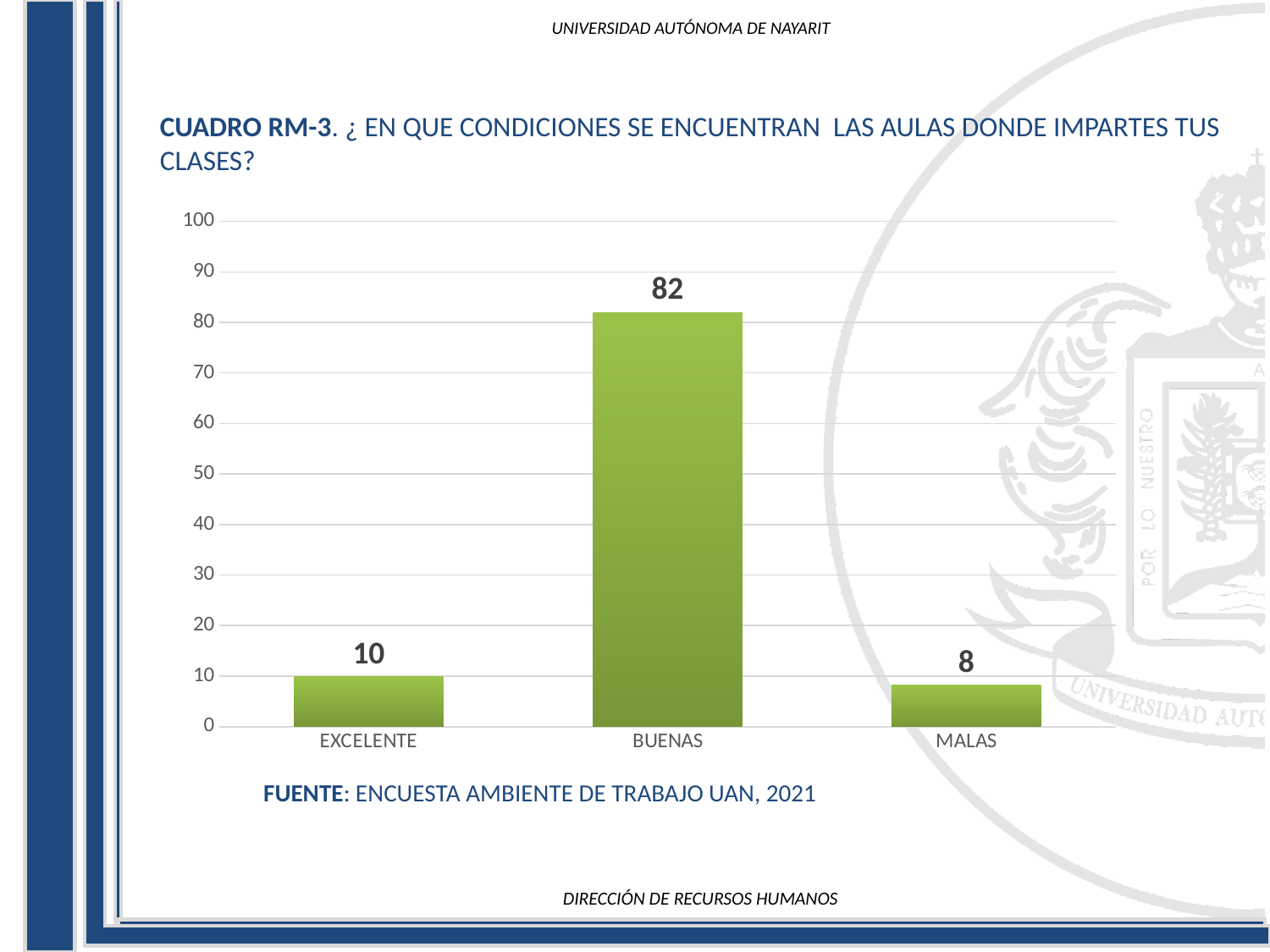
What is the difference between the values for EXCELENTE and MALAS? 2 What is the value for BUENAS? 82 What is the difference between the values for BUENAS and EXCELENTE? 72 Which is larger, the value for EXCELENTE or the value for MALAS? EXCELENTE What kind of chart is shown on the slide? bar chart Which category has the highest value? BUENAS Is the value for BUENAS greater or less than 80? greater How many categories are shown on the x axis? 3 What is the value for MALAS? 8 What source is cited below the chart? ENCUESTA AMBIENTE DE TRABAJO UAN, 2021 What is the value for EXCELENTE? 10 Which category has the lowest value? MALAS